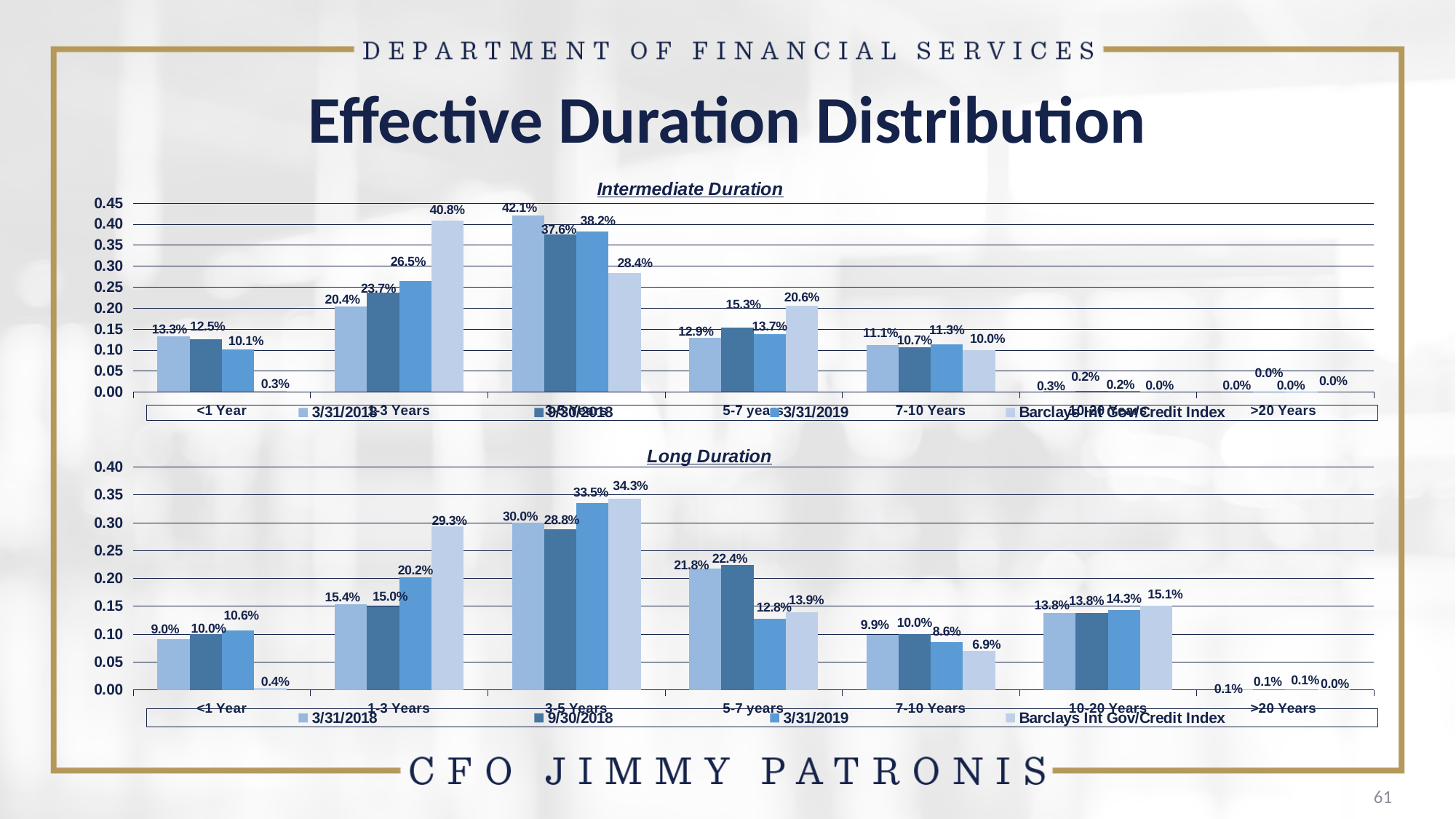
In the Long Duration chart, what is the value for 3/31/2019 in the 5-7 years category? 12.8% How many series does the legend of the Intermediate Duration chart list? 4 In the Intermediate Duration chart, what is the value for 3/31/2018 in the 3-5 Years category? 42.1% How many categories are shown on the x axis of the Long Duration chart? 7 What type of chart is the Long Duration chart? Bar chart In the Intermediate Duration chart, which category has the lowest value for the 3/31/2018 series? >20 Years In the Intermediate Duration chart, what is the Barclays Int Gov/Credit Index value for 1-3 Years? 40.8% In the Intermediate Duration chart, what is the difference between the 3/31/2018 and 3/31/2019 values for 3-5 Years? 3.9% In the Long Duration chart, what is the difference between the Barclays Int Gov/Credit Index and 3/31/2018 values for 1-3 Years? 13.9% In the Long Duration chart, which is larger for 5-7 years: the 9/30/2018 value or the 3/31/2019 value? 9/30/2018 In the Intermediate Duration chart, is the 3/31/2019 value for 1-3 Years greater or less than 0.25? greater In the Long Duration chart, which category has the highest value for the Barclays Int Gov/Credit Index series? 3-5 Years